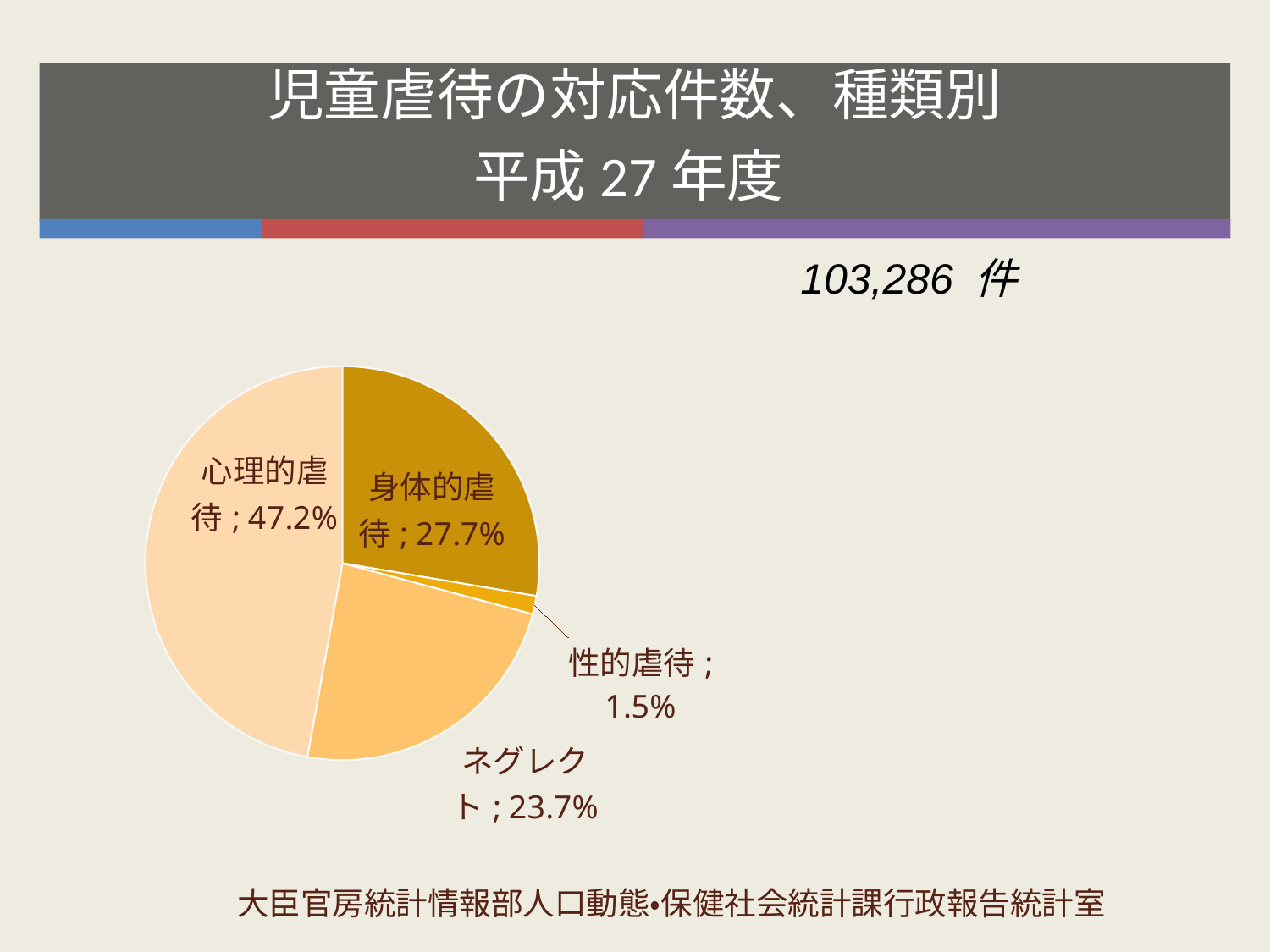
How many categories are shown in the pie chart? 4 Which is larger, the share for 身体的虐待 or the share for ネグレクト? 身体的虐待 What kind of chart is shown on the slide? pie chart What is the title of the slide? 児童虐待の対応件数、種類別 平成27年度 What share of the pie is ネグレクト? 23.7% What total number of cases is shown on the slide? 103,286 件 Which category has the smallest slice of the pie? 性的虐待 Which category has the largest slice of the pie? 心理的虐待 What share of the pie is 心理的虐待? 47.2% What share of the pie is 性的虐待? 1.5% What is the difference in percentage points between 心理的虐待 and 身体的虐待? 19.5